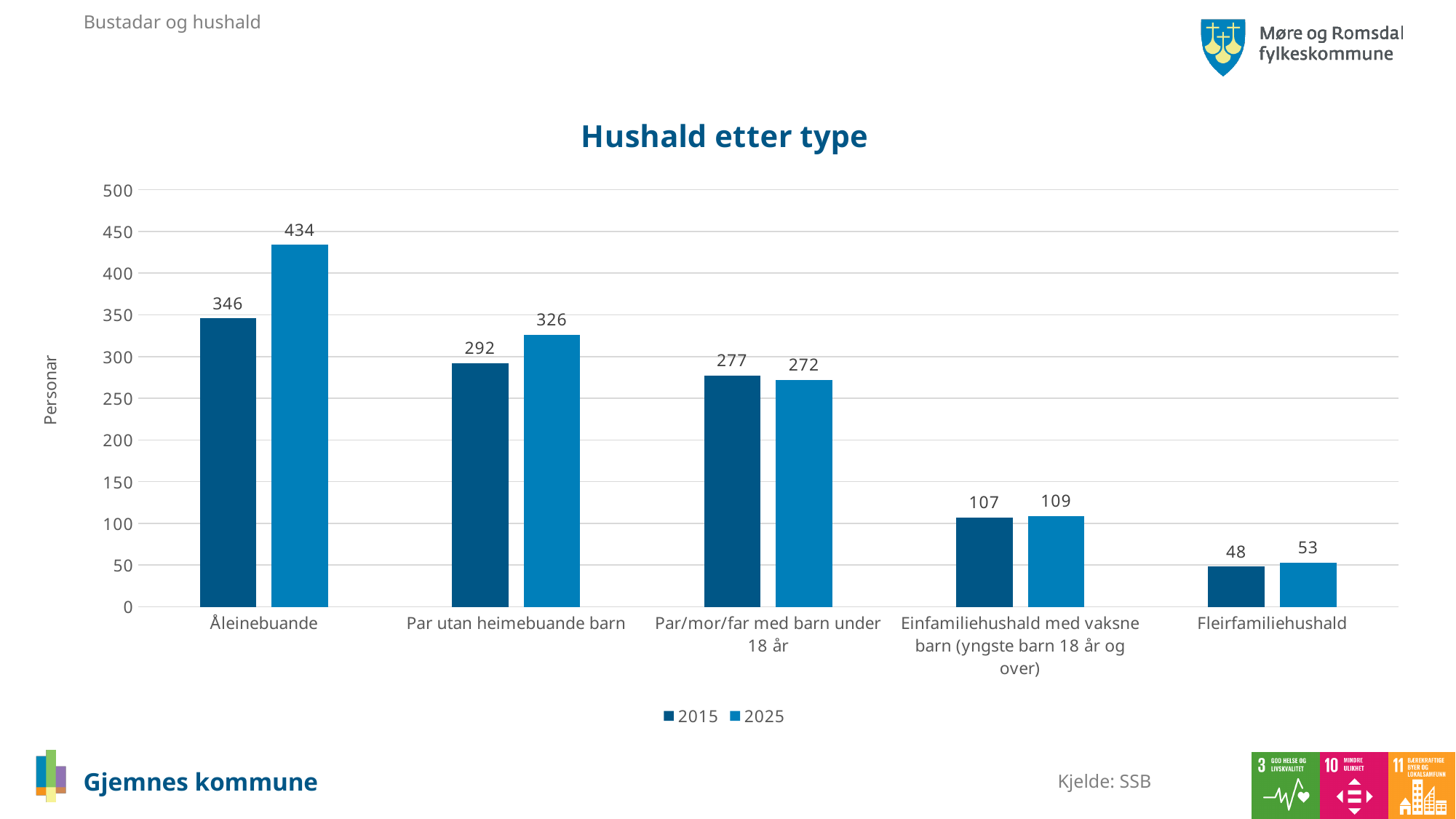
What is the difference between the 2025 and 2015 values for Åleinebuande? 88 What is the value for Par utan heimebuande barn in 2015? 292 Which category has the lowest value in 2015? Fleirfamiliehushald What is the value for Fleirfamiliehushald in 2025? 53 Which is larger for Par/mor/far med barn under 18 år: the 2015 value or the 2025 value? 2015 How many categories are shown on the x axis? 5 What kind of chart is shown? Bar chart How many series does the legend list? 2 Which category has the highest value in 2025? Åleinebuande What is the value for Åleinebuande in 2025? 434 What is the label on the y axis? Personar What is the title of the chart? Hushald etter type